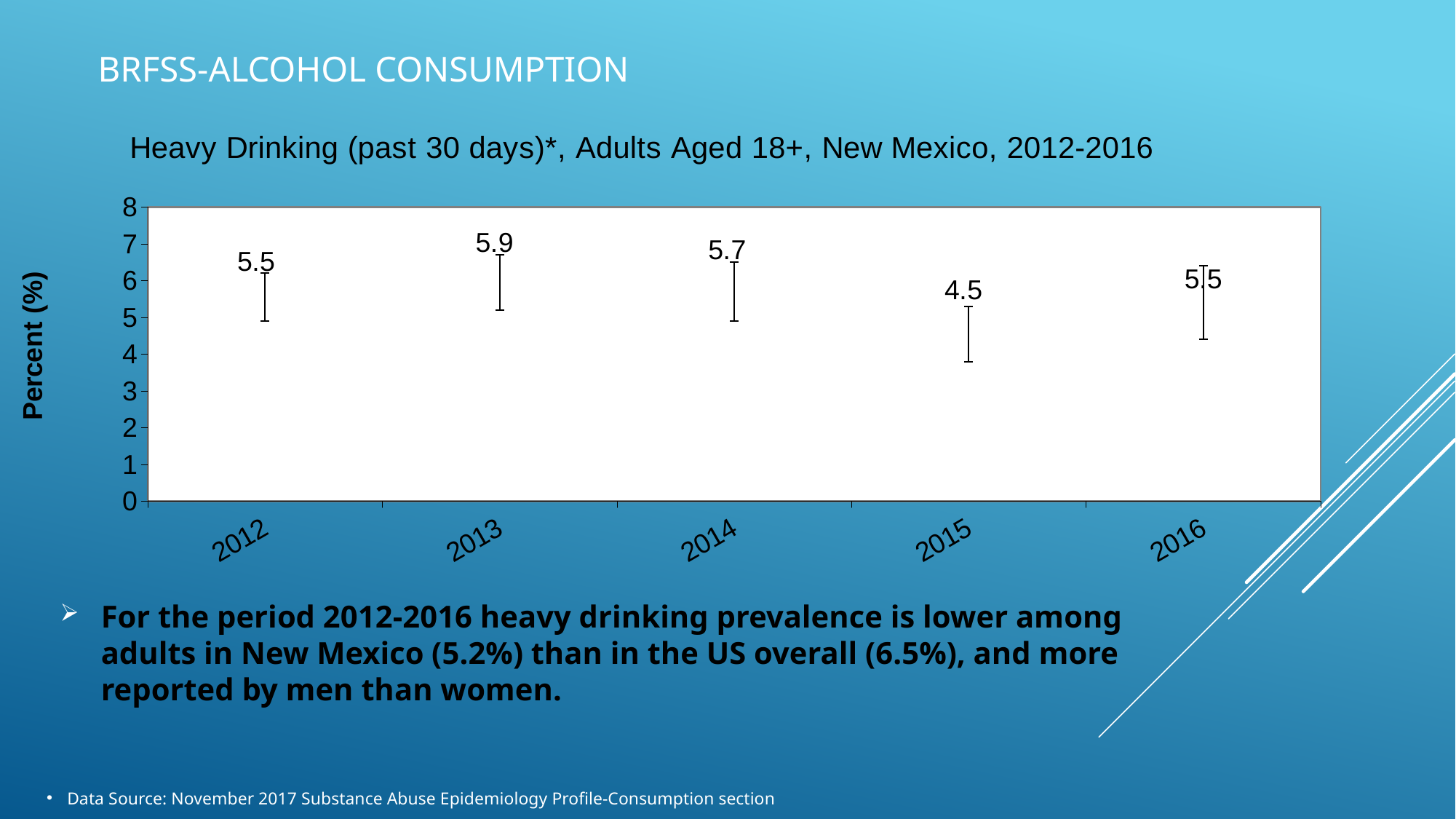
What is the label on the vertical axis of the chart? Percent (%) Which year has a higher heavy drinking percentage, 2014 or 2016? 2014 What is the difference between the 2013 and 2015 heavy drinking percentages? 1.4 What is the heavy drinking percentage for 2012? 5.5 What is the difference between the 2014 and 2012 heavy drinking percentages? 0.2 What is the heavy drinking percentage for 2015? 4.5 What is the heavy drinking percentage for 2014? 5.7 Which year has the highest heavy drinking percentage? 2013 How many years are plotted on the chart? 5 Which year has the lowest heavy drinking percentage? 2015 What is the heavy drinking percentage for 2013? 5.9 What is the title of the chart? Heavy Drinking (past 30 days)*, Adults Aged 18+, New Mexico, 2012-2016